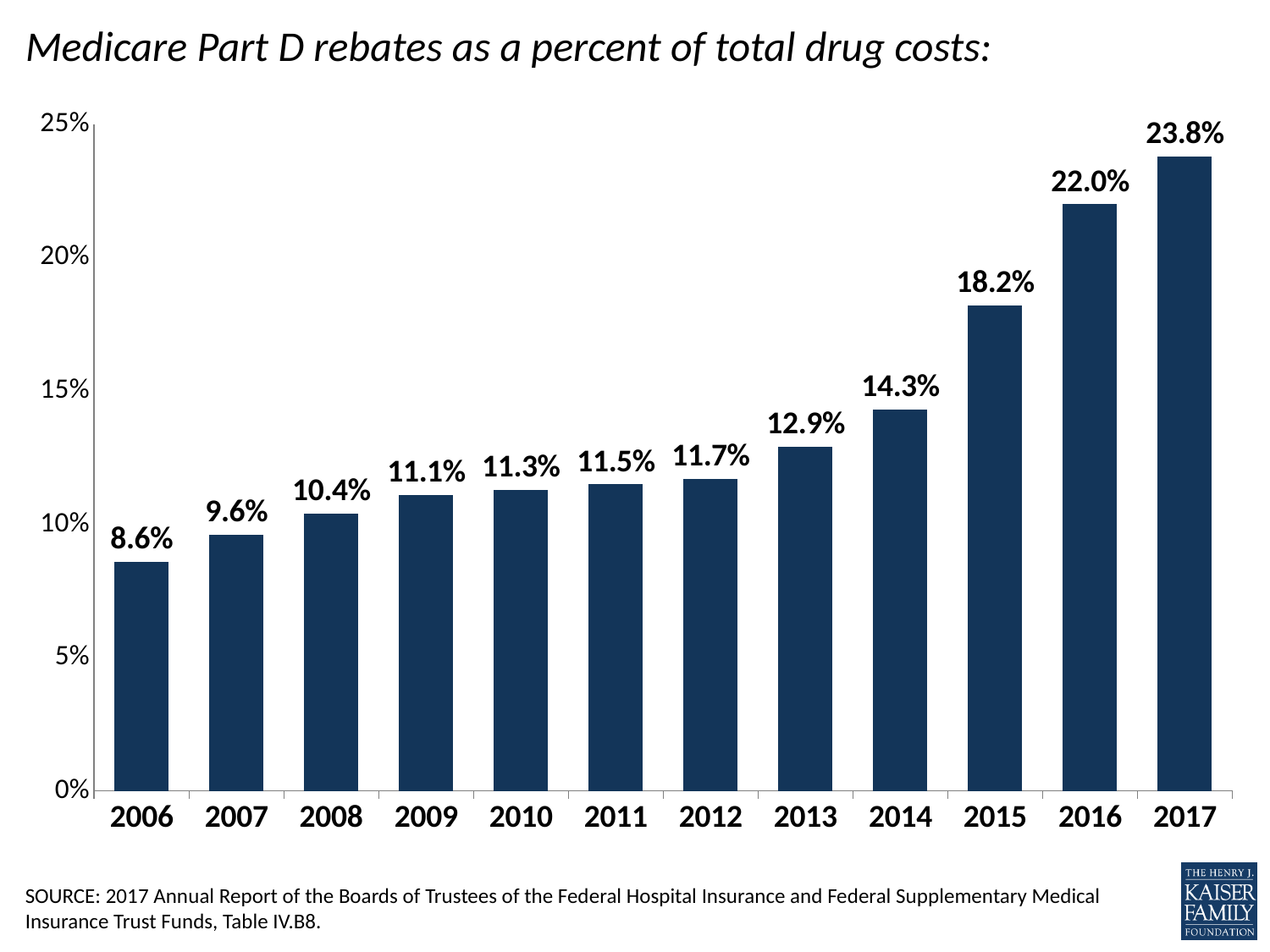
What kind of chart is this? Bar chart How many years are shown on the x axis? 12 What value is shown for 2016? 22.0% Do the values rise or fall from 2006 to 2017? Rise Which year has a larger value, 2012 or 2014? 2014 What was the Medicare Part D rebate percentage of total drug costs in 2006? 8.6% What value is shown for 2013? 12.9% What is the difference in percentage points between the 2017 and 2006 values? 15.2 percentage points Is the value for 2015 greater or less than 15%? greater Which year has the lowest rebate percentage? 2006 Which year has the highest rebate percentage? 2017 What is the difference between the 2015 and 2014 values? 3.9 percentage points